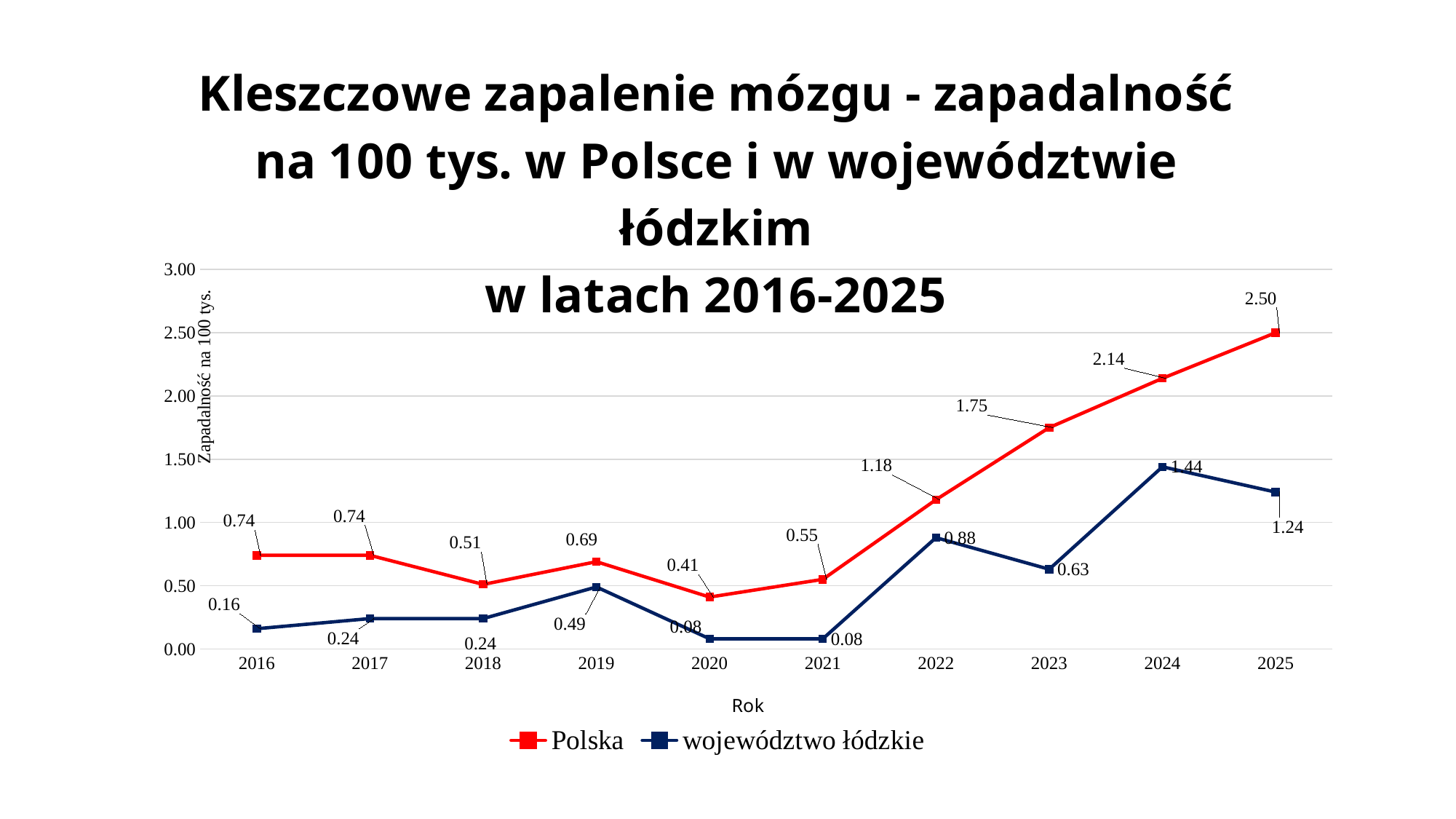
What is the value for Polska in 2020? 0.41 Which series has the higher value in 2023, Polska or województwo łódzkie? Polska How many years are plotted on the x axis? 10 How many series does the legend list? 2 What is the value for województwo łódzkie in 2024? 1.44 What type of chart is shown on the slide? line chart What is the difference between the Polska and województwo łódzkie values in 2025? 1.26 In which year is the value for Polska the lowest? 2020 What is the value for Polska in 2025? 2.50 Is the value for Polska in 2024 greater or less than 2.00? greater Does the value for Polska rise or fall from 2021 to 2025? rise In which year is the value for województwo łódzkie the highest? 2024